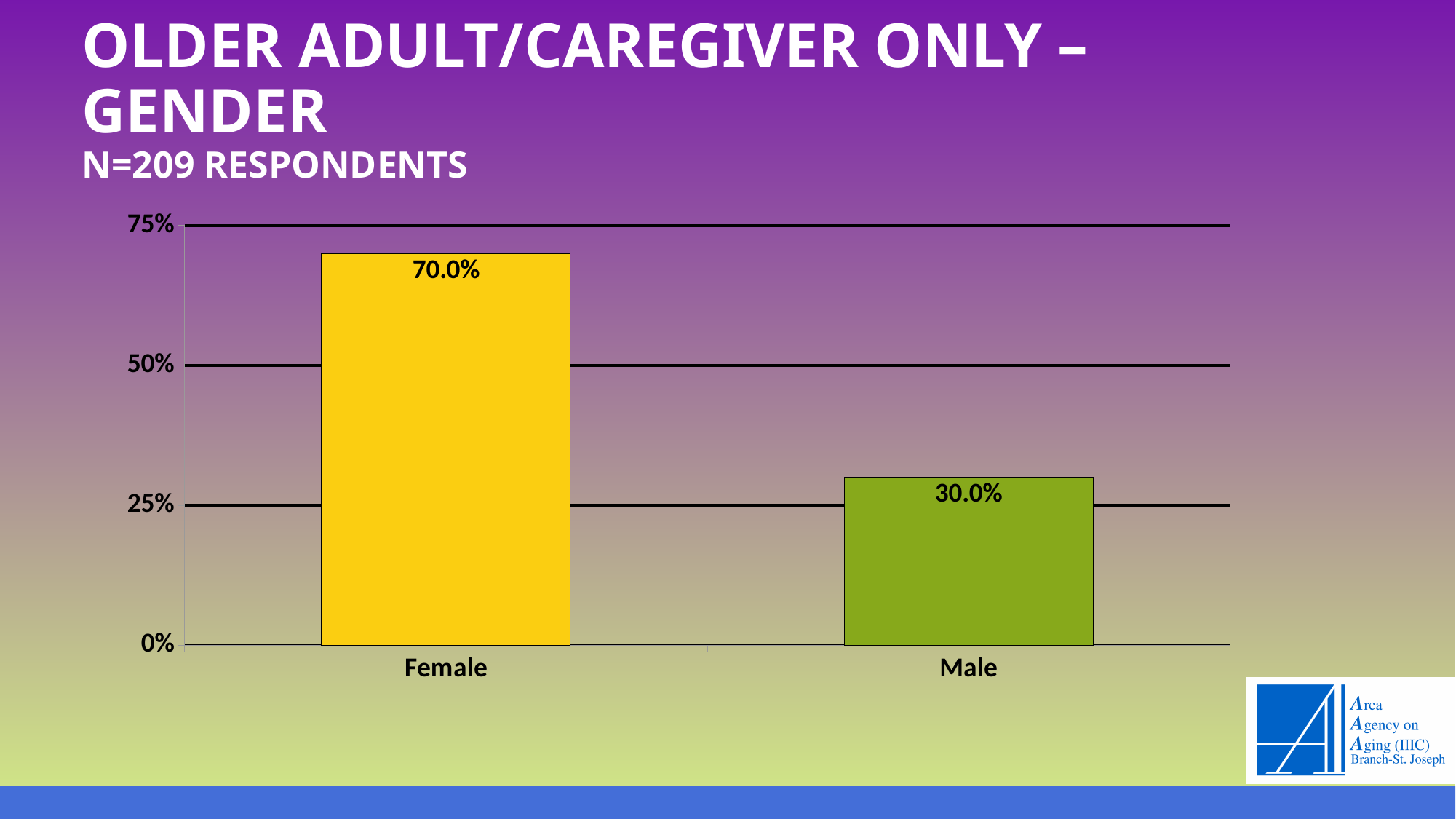
How many gender categories are shown on the chart? 2 Which gender category has the highest value? Female Which is larger, the value for Female or the value for Male? Female What kind of chart is shown on the slide? bar chart What percentage of respondents are Male? 30.0% What is the difference in percentage points between Female and Male respondents? 40.0% What percentage of respondents are Female? 70.0% How many respondents does the slide say the chart is based on? 209 Is the value for Female greater or less than 50%? greater What colour is the bar for Female? yellow Which gender category has the lowest value? Male Is the value for Male greater or less than 50%? less